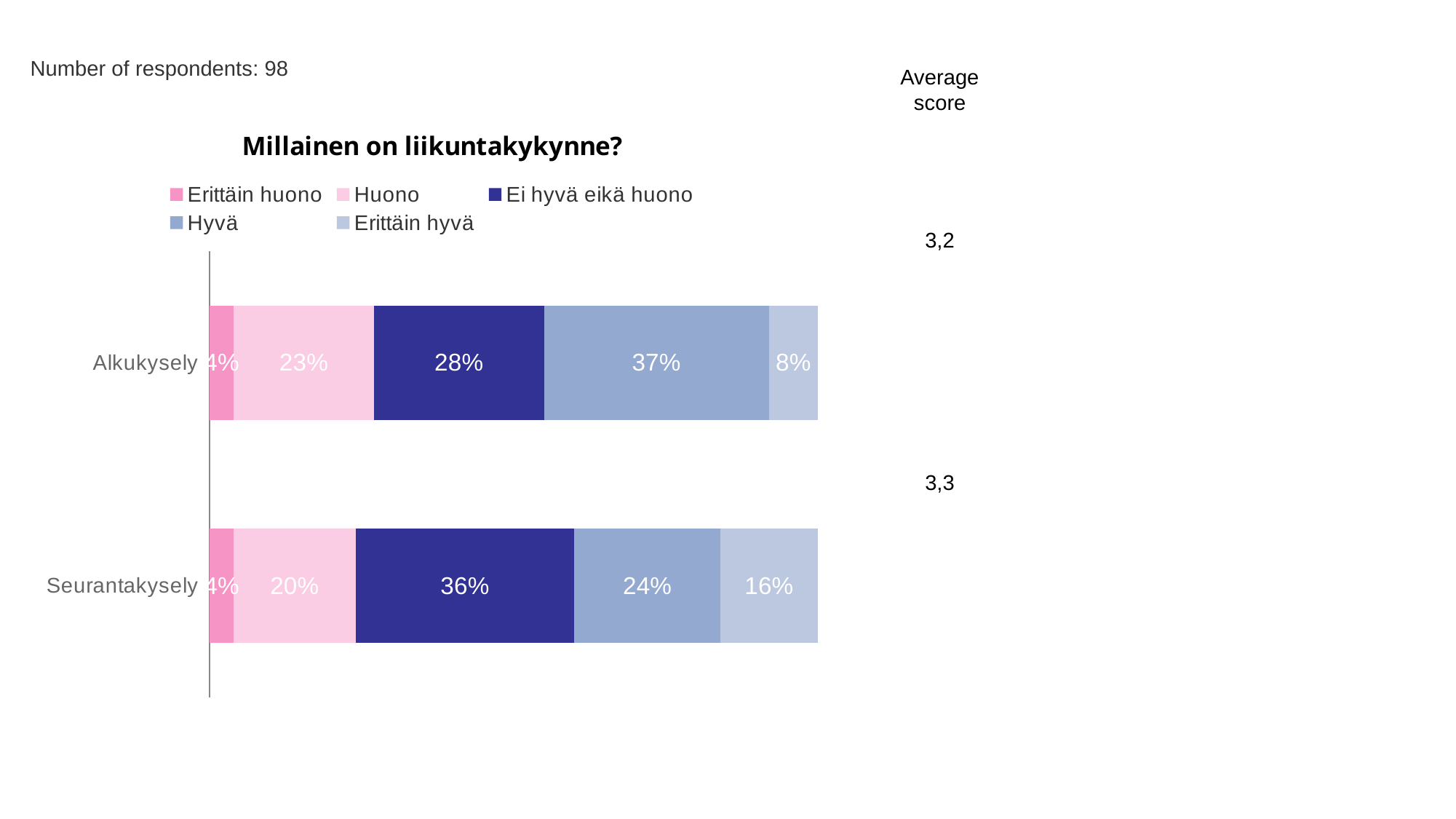
What is the value for Huono in the Alkukysely bar? 23% What is the title of the chart? Millainen on liikuntakykynne? What is the value for Ei hyvä eikä huono in the Seurantakysely bar? 36% Which segment is the smallest in the Seurantakysely bar? Erittäin huono How many categories (bars) are shown in the chart? 2 Which bar has the larger Erittäin hyvä value, Alkukysely or Seurantakysely? Seurantakysely How many series does the legend list? 5 What is the value for Hyvä in the Alkukysely bar? 37% What is the difference between the Hyvä values for Alkukysely and Seurantakysely? 13% What kind of chart is shown on the slide? Stacked bar chart Which segment is the largest in the Alkukysely bar? Hyvä What is the value for Erittäin hyvä in the Seurantakysely bar? 16%